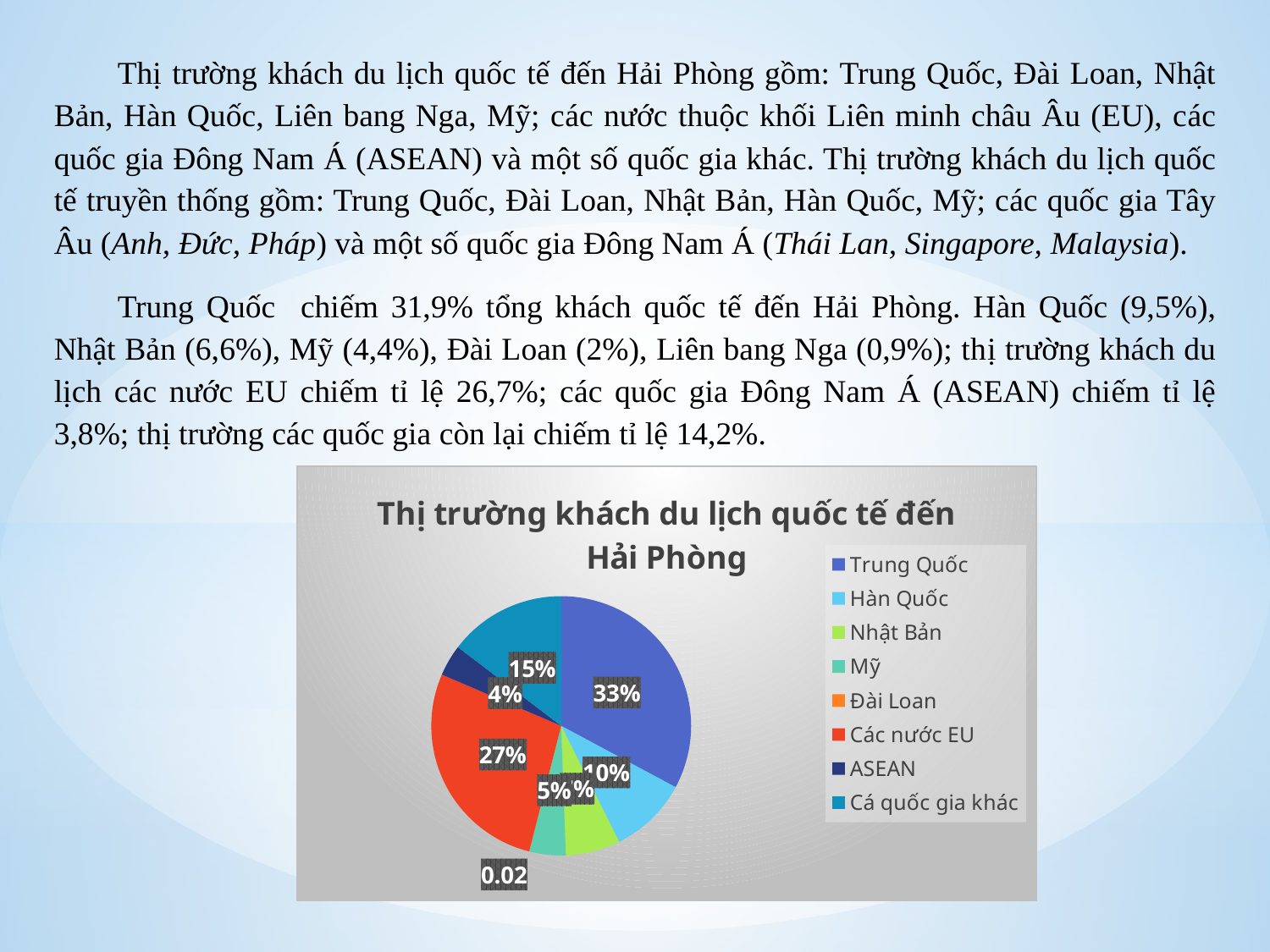
Which category has the largest slice of the pie? Trung Quốc What share of the pie does Cá quốc gia khác have? 15% What is the title of the pie chart? Thị trường khách du lịch quốc tế đến Hải Phòng By how many percentage points does the Trung Quốc slice exceed the Các nước EU slice? 6% How many categories does the legend of the pie chart list? 8 What share of the pie does Mỹ have? 5% What share of the pie does ASEAN have? 4% What share of the pie does Các nước EU have? 27% What share of the pie does Trung Quốc have? 33% What kind of chart is shown on the slide? pie chart What share of the pie does Hàn Quốc have? 10% Which slice is larger, Các nước EU or Cá quốc gia khác? Các nước EU